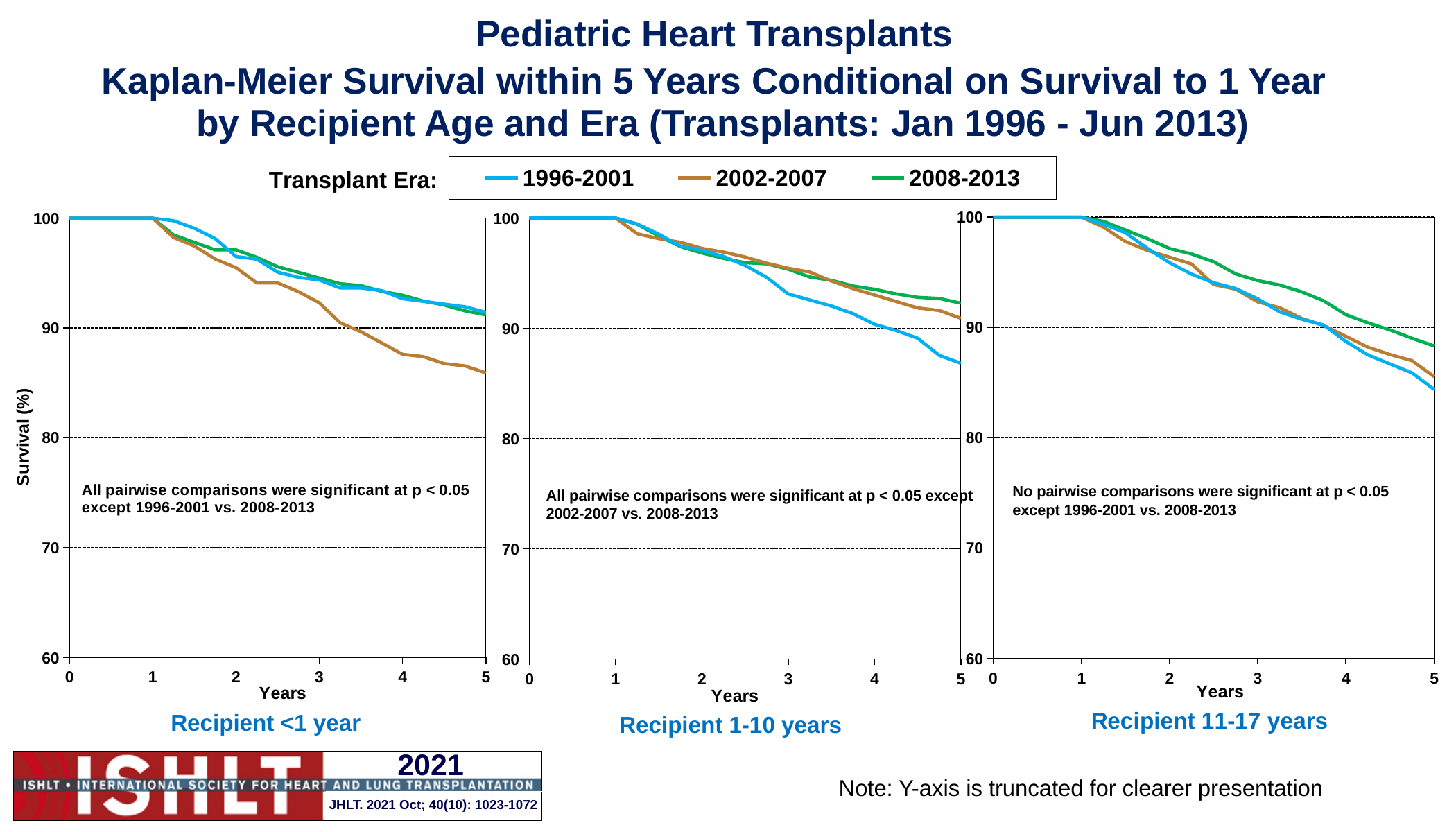
How many transplant eras does the legend list? 3 How many charts are shown on the slide? 3 In the Recipient <1 year chart, is the survival value for the 2002-2007 era at year 5 greater or less than 90? less What is the label on the y axis of the charts? Survival (%) What kind of chart is used for the Recipient <1 year panel? Line chart In the Recipient <1 year chart, what is the survival value for the 1996-2001 era at year 0? 100 In the Recipient 1-10 years chart, is the survival value for the 1996-2001 era at year 5 greater or less than 90? less In the Recipient 11-17 years chart, which era has the highest survival at year 5? 2008-2013 In the Recipient 11-17 years chart, is the survival value for the 1996-2001 era at year 5 greater or less than 90? less In the Recipient 1-10 years chart, which era has higher survival at year 5, 1996-2001 or 2008-2013? 2008-2013 In the Recipient 11-17 years chart, does survival rise or fall as years increase? Fall In the Recipient <1 year chart, which era has the lowest survival at year 5? 2002-2007